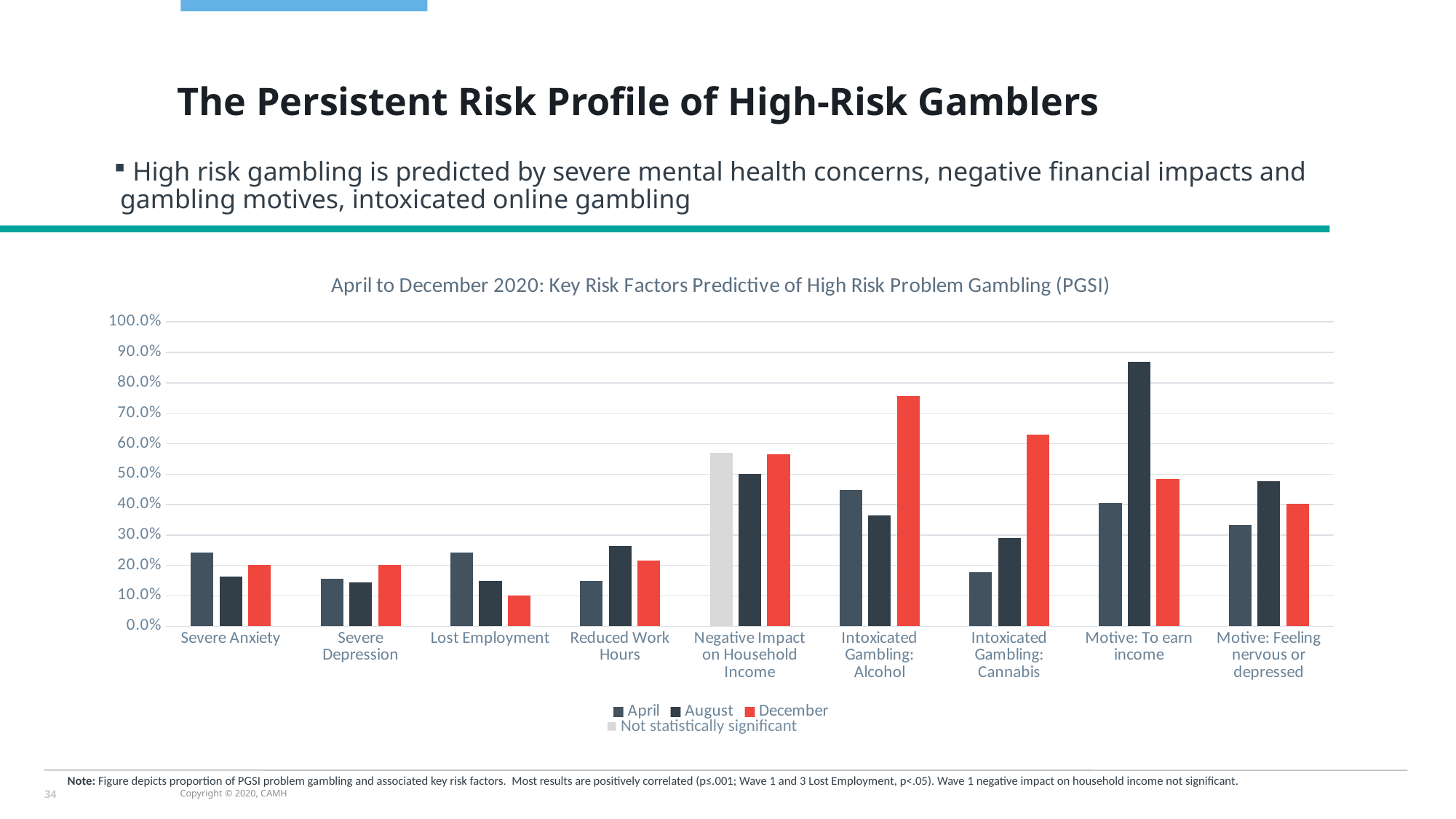
Is the December value for Intoxicated Gambling: Alcohol greater or less than 70.0%? greater What kind of chart is shown on the slide? Bar chart How many risk factor categories are shown on the x axis of the chart? 9 Which category has the lowest December value? Lost Employment Which category has the highest December value? Intoxicated Gambling: Alcohol For Intoxicated Gambling: Cannabis, which is larger, the August value or the December value? December Which category has the highest August value? Motive: To earn income Is the August value for Motive: To earn income greater or less than 80.0%? greater How many entries does the chart's legend list? 4 Is the December value for Lost Employment greater or less than 20.0%? less What does the grey bar in the Negative Impact on Household Income category indicate, according to the legend? Not statistically significant Do the values for Lost Employment rise or fall from April to August to December? fall